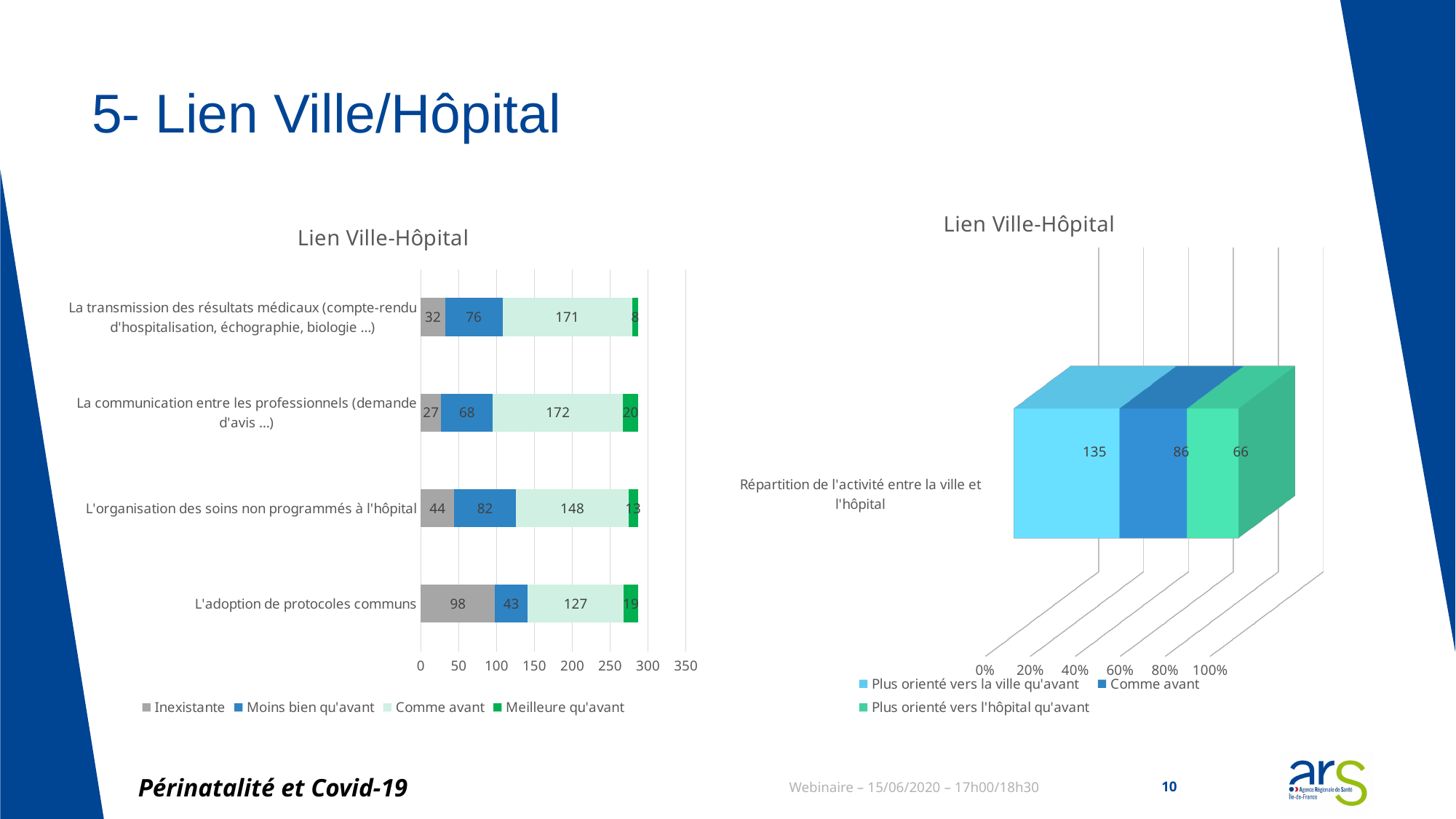
On the left chart, what is the 'Moins bien qu'avant' value for 'L'organisation des soins non programmés à l'hôpital'? 82 On the left chart, how many series does the legend list? 4 What kind of chart is the left chart? Stacked bar chart On the left chart, what is the 'Comme avant' value for 'La communication entre les professionnels (demande d'avis ...)'? 172 On the left chart, what is the 'Inexistante' value for 'L'adoption de protocoles communs'? 98 On the right chart, what is the value for 'Plus orienté vers la ville qu'avant'? 135 On the left chart, which category has the highest 'Inexistante' value? L'adoption de protocoles communs On the left chart, how many categories are shown? 4 On the right chart, which is larger: 'Comme avant' or 'Plus orienté vers l'hôpital qu'avant'? Comme avant On the left chart, what is the difference between the 'Comme avant' values for 'La transmission des résultats médicaux' and 'L'adoption de protocoles communs'? 44 On the left chart, which category has the lowest 'Meilleure qu'avant' value? La transmission des résultats médicaux (compte-rendu d'hospitalisation, échographie, biologie ...) On the left chart, what is the total of the stacked bar for 'L'organisation des soins non programmés à l'hôpital'? 287